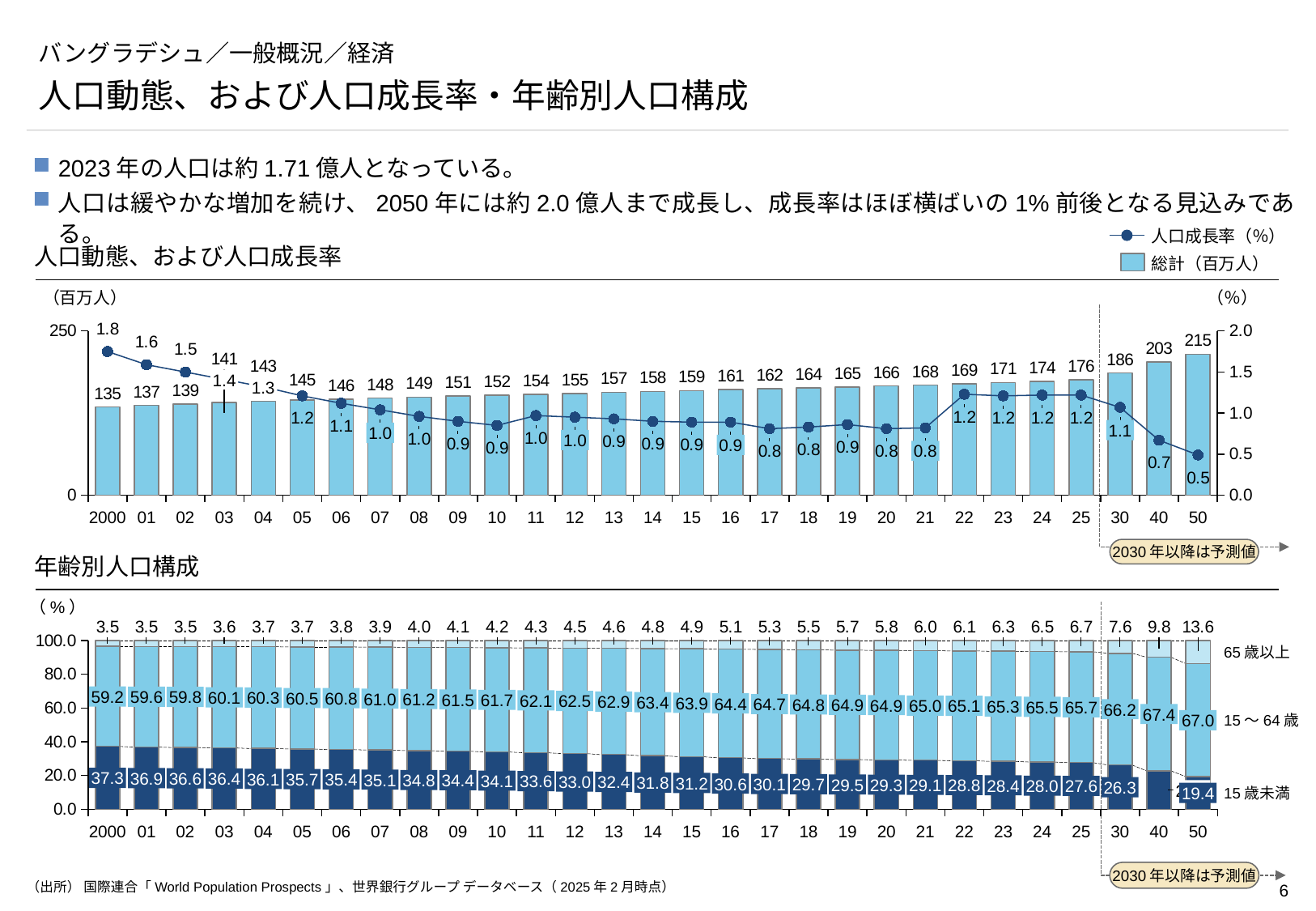
What kind of chart is the 年齢別人口構成 chart? stacked bar chart In the 人口動態、および人口成長率 chart, does the total population rise or fall from 2000 to 2050? rise In the 年齢別人口構成 chart, what is the share of 15歳未満 in 2000? 37.3 In the 年齢別人口構成 chart, which is larger in 2025: the share of 15～64歳 or the share of 15歳未満? 15～64歳 In the 人口動態、および人口成長率 chart, which year has the highest total population? 2050 In the 人口動態、および人口成長率 chart, what is the 人口成長率 (%) for 2050? 0.5 In the 人口動態、および人口成長率 chart, how many series does the legend list? 2 In the 年齢別人口構成 chart, what is the difference between the 15～64歳 share in 2040 and in 2000? 8.2 In the 年齢別人口構成 chart, what is the share of 65歳以上 in 2050? 13.6 In the 人口動態、および人口成長率 chart, what is the 人口成長率 (%) for 2000? 1.8 In the 人口動態、および人口成長率 chart, what is the difference in total population (百万人) between 2050 and 2000? 80 In the 人口動態、および人口成長率 chart, what is the total population (百万人) for 2023? 171